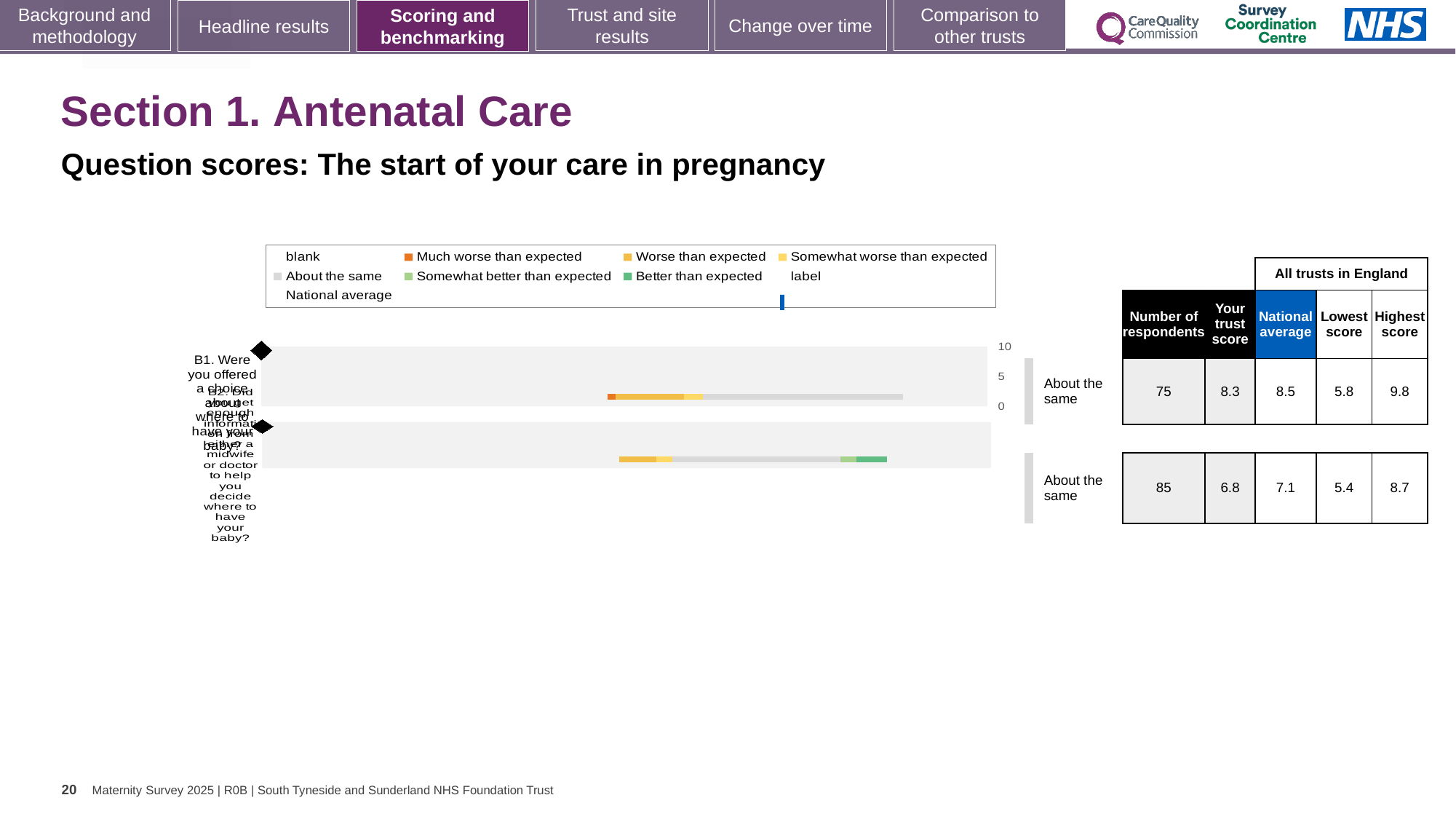
What is the lowest score among all trusts in England for the first row (B1)? 5.8 What is the 'Your trust score' value for the first row (B1) in the table? 8.3 What benchmark category is shown next to both bars in the chart? About the same What is the national average for the second row (B2) in the table? 7.1 How many respondents are listed for the first row (B1)? 75 What kind of chart is used to show the question scores on this slide? bar chart By how much does the national average exceed the trust score for the first row (B1)? 0.2 Which row has more respondents, the first (B1) or the second (B2)? the second (B2), with 85 How many questions (bars) are plotted in the chart? 2 What is the difference between the highest and lowest scores for the first row (B1)? 4.0 What is the highest score among all trusts in England for the second row (B2)? 8.7 Which legend entry is shown in dark green? Better than expected